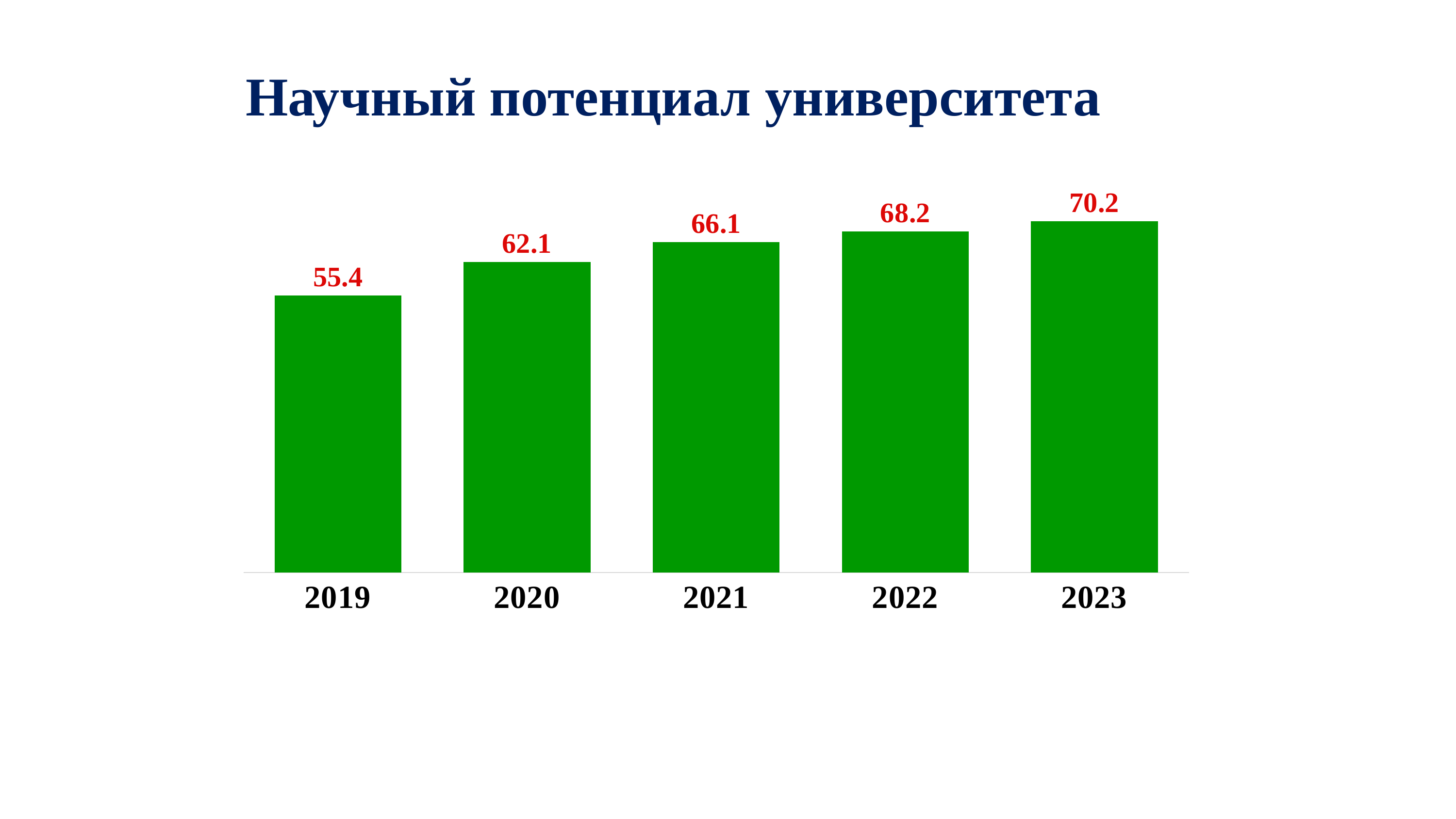
What is the value for 2019? 55.4 What is the difference between the values for 2020 and 2019? 6.7 What kind of chart is shown on the slide? bar chart How many years are shown on the chart? 5 Which year has the highest value? 2023 Which year has the lowest value? 2019 What is the value for 2023? 70.2 What is the value for 2021? 66.1 What is the difference between the values for 2023 and 2019? 14.8 Which is larger, the value for 2020 or the value for 2022? 2022 Do the values rise or fall from 2019 to 2023? rise What is the title of the slide? Научный потенциал университета